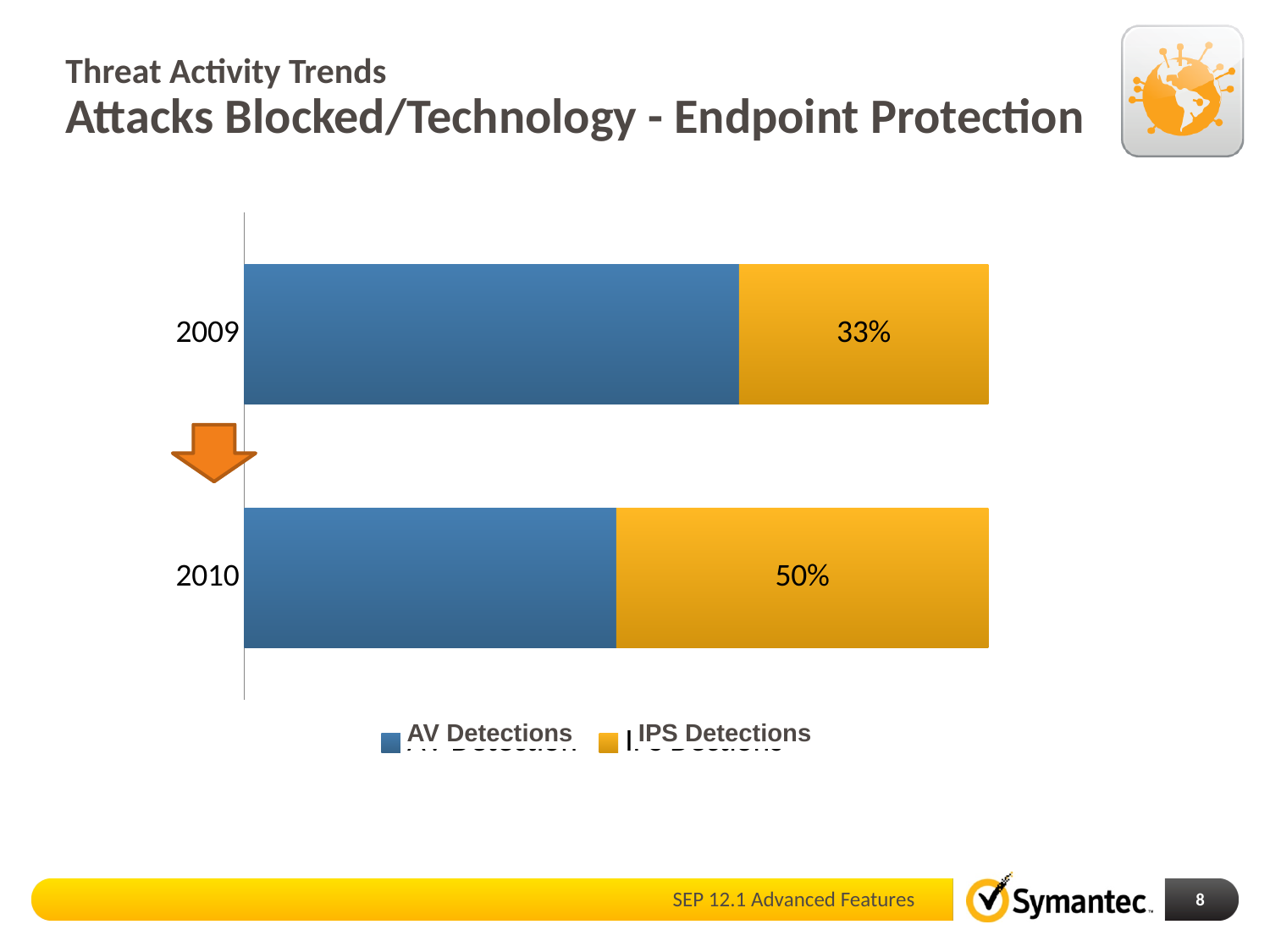
Which year has the higher IPS Detections value, 2009 or 2010? 2010 What is the IPS Detections value for 2009? 33% How many series does the legend list? 2 By how much did the IPS Detections share change from 2009 to 2010? 17 percentage points How many years (categories) are shown in the chart? 2 What are the two series named in the legend? AV Detections and IPS Detections In the 2009 bar, which segment is larger, AV Detections or IPS Detections? AV Detections Which colour represents IPS Detections in the chart? Orange Does the IPS Detections share rise or fall from 2009 to 2010? Rise What is the IPS Detections value for 2010? 50% What kind of chart is shown on the slide? Stacked bar chart Which year has the lowest IPS Detections value? 2009